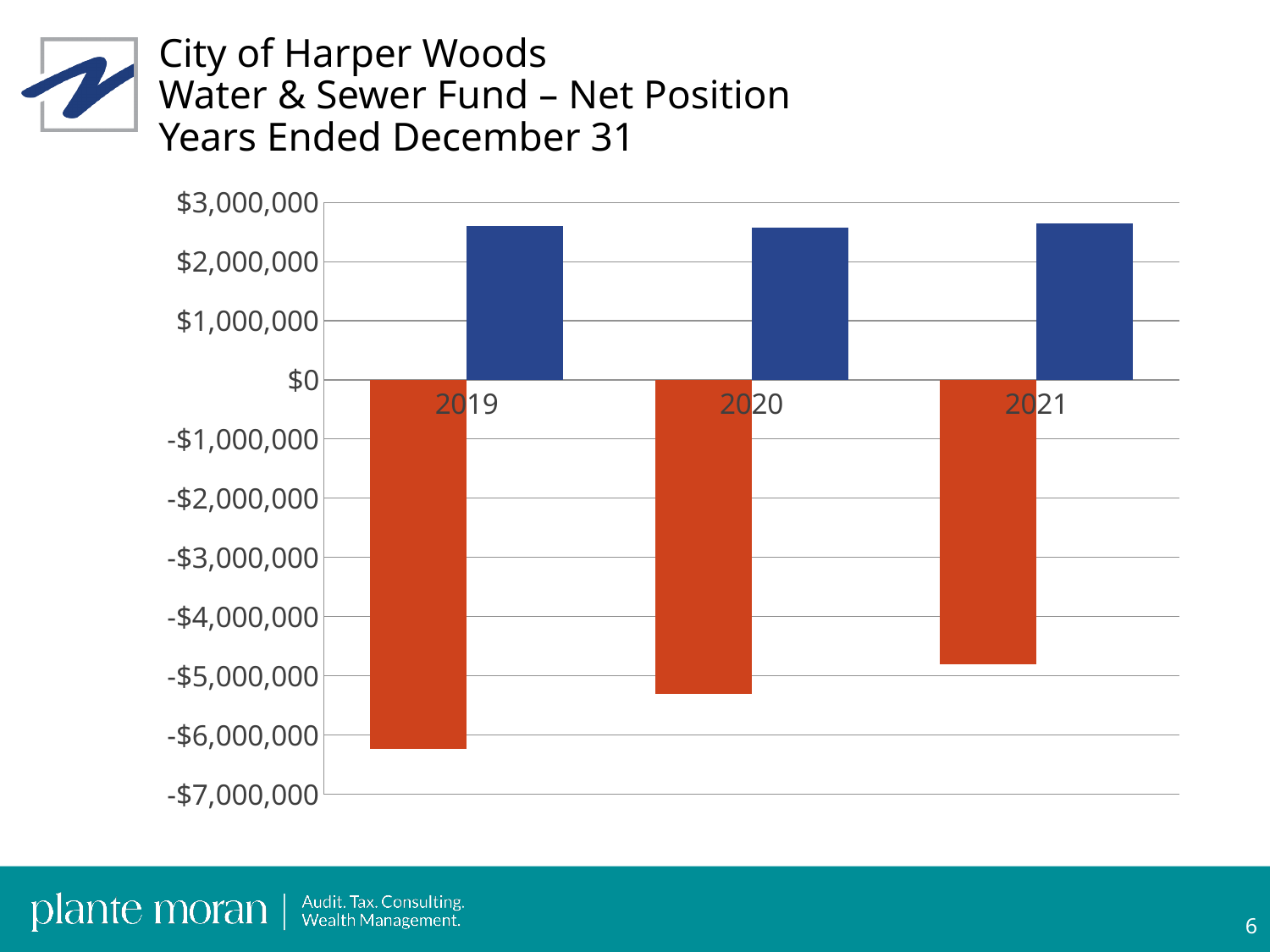
What kind of chart is shown on the slide? bar chart Is the value of the orange bar for 2019 greater or less than -$6,000,000? less What fund does the chart title say the net position is for? Water & Sewer Fund Is the value of the blue bar for 2019 greater or less than $2,000,000? greater Is the value of the orange bar for 2020 greater or less than -$5,000,000? less Do the orange bar values rise or fall from 2019 to 2021? rise Which year has the highest (least negative) orange bar? 2021 Which year has the lowest (most negative) orange bar? 2019 How many years are shown on the x axis of the chart? 3 How many differently coloured bar series are plotted in the chart? 2